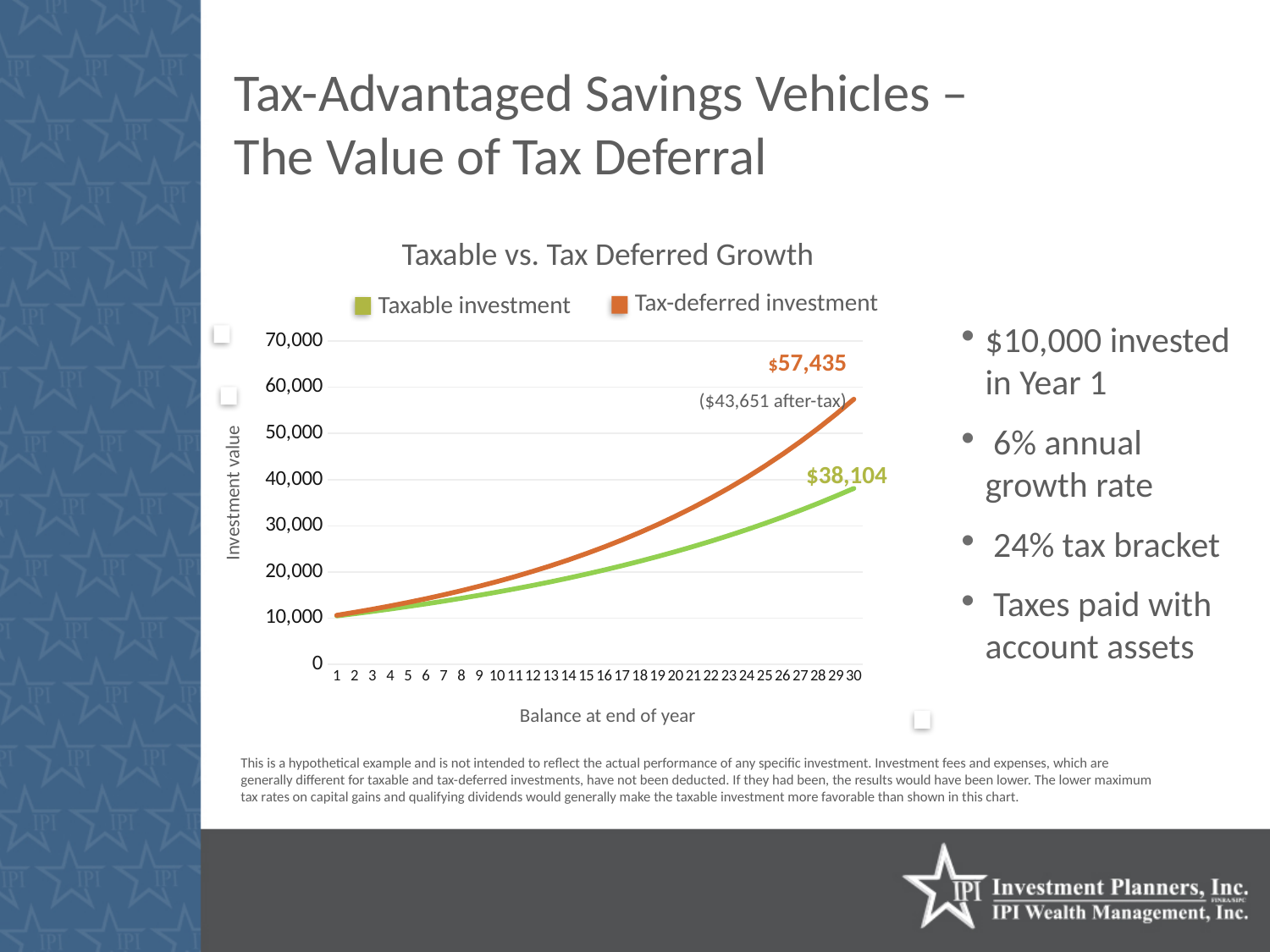
What is the value of the tax-deferred investment at the end of year 30? $57,435 Is the value of the taxable investment at year 20 greater or less than 30,000? less What is the title of the chart's x axis? Balance at end of year Is the value of the tax-deferred investment at year 10 greater or less than 20,000? less Do the values of both series rise or fall as the years increase along the x axis? rise What kind of chart is shown on the slide? line chart What is the value of the taxable investment at the end of year 30? $38,104 How many years are plotted along the x axis of the chart? 30 What is the difference between the tax-deferred investment value and the taxable investment value at year 30? $19,331 What is the after-tax value shown for the tax-deferred investment at year 30? $43,651 Which series has the higher value at year 30, the taxable investment or the tax-deferred investment? Tax-deferred investment How many series does the legend of the chart list? 2